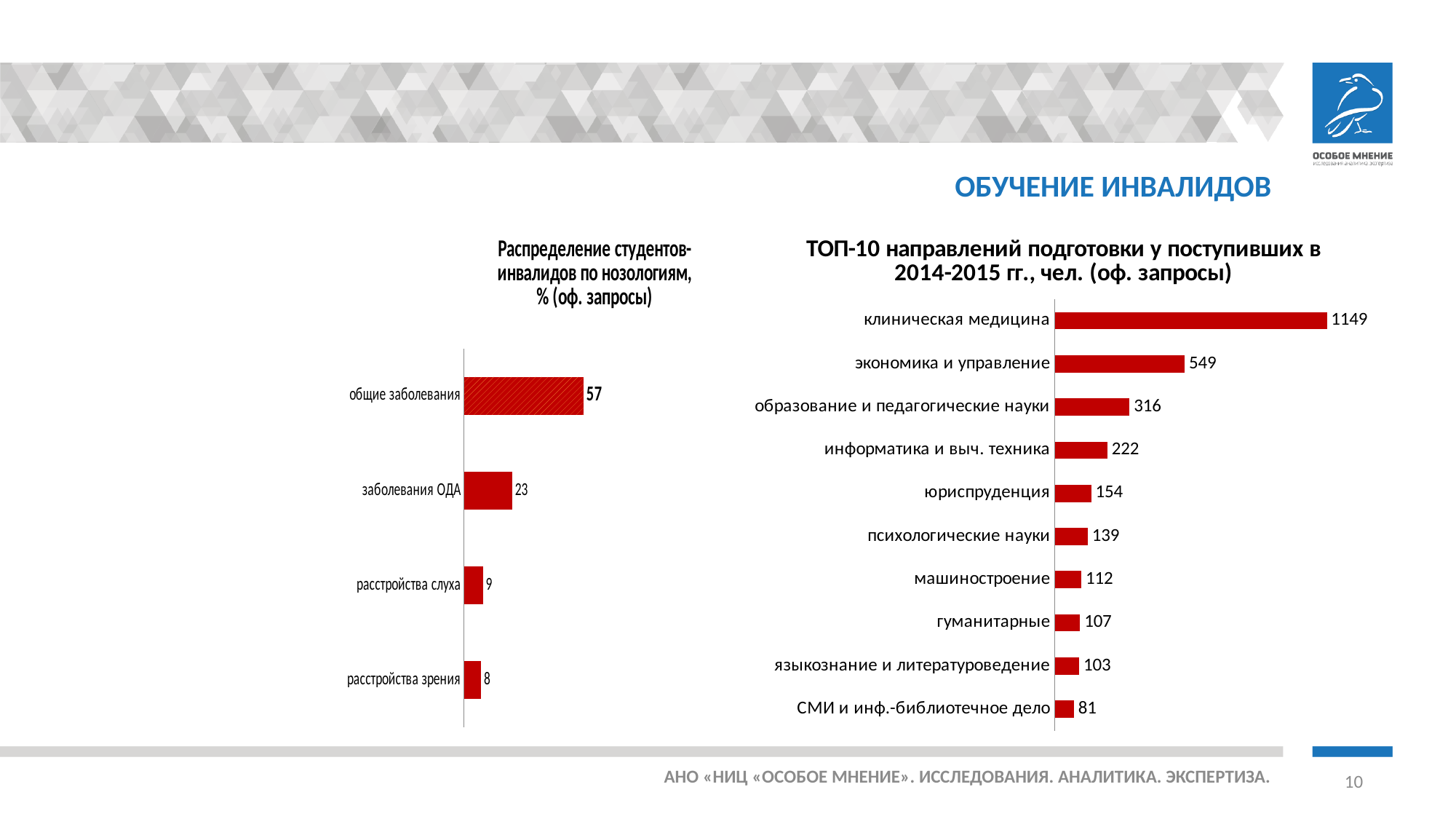
In the left chart (Распределение студентов-инвалидов по нозологиям), how many categories are shown? 4 In the right chart (ТОП-10 направлений подготовки), what is the value for юриспруденция? 154 In the left chart (Распределение студентов-инвалидов по нозологиям), which category has the lowest value? расстройства зрения In the right chart (ТОП-10 направлений подготовки), how many categories are shown? 10 In the right chart (ТОП-10 направлений подготовки), which is larger: экономика и управление or образование и педагогические науки? экономика и управление In the left chart (Распределение студентов-инвалидов по нозологиям), what is the value for общие заболевания? 57 In the right chart (ТОП-10 направлений подготовки), what is the difference between клиническая медицина and экономика и управление? 600 In the right chart (ТОП-10 направлений подготовки), what is the value for клиническая медицина? 1149 In the right chart (ТОП-10 направлений подготовки), which category has the lowest value? СМИ и инф.-библиотечное дело What type of chart is the right chart (ТОП-10 направлений подготовки)? bar chart In the left chart (Распределение студентов-инвалидов по нозологиям), what is the difference between общие заболевания and заболевания ОДА? 34 In the left chart (Распределение студентов-инвалидов по нозологиям), what is the value for заболевания ОДА? 23